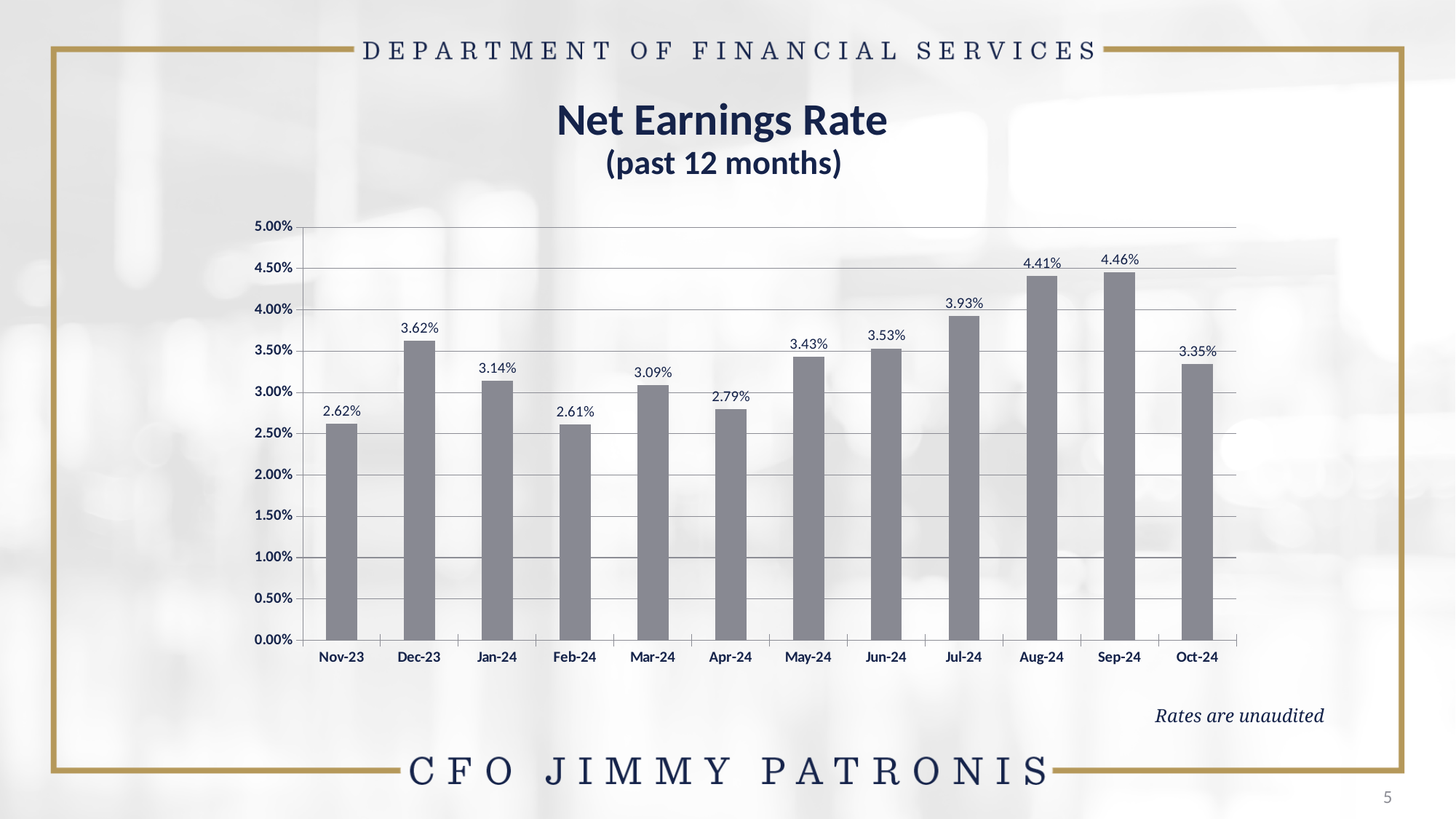
What is the difference between the net earnings rate for Dec-23 and Jan-24? 0.48% What is the difference between the net earnings rate for Sep-24 and Oct-24? 1.11% Which month has the highest net earnings rate? Sep-24 What is the net earnings rate for Sep-24? 4.46% Which month has the lowest net earnings rate? Feb-24 What is the net earnings rate for Feb-24? 2.61% Is the net earnings rate for Aug-24 greater or less than 4.00%? greater Which month has a higher net earnings rate, Mar-24 or Apr-24? Mar-24 What is the net earnings rate for Jun-24? 3.53% What is the title of the chart? Net Earnings Rate (past 12 months) What kind of chart is shown on the slide? Bar chart How many months are shown on the chart? 12